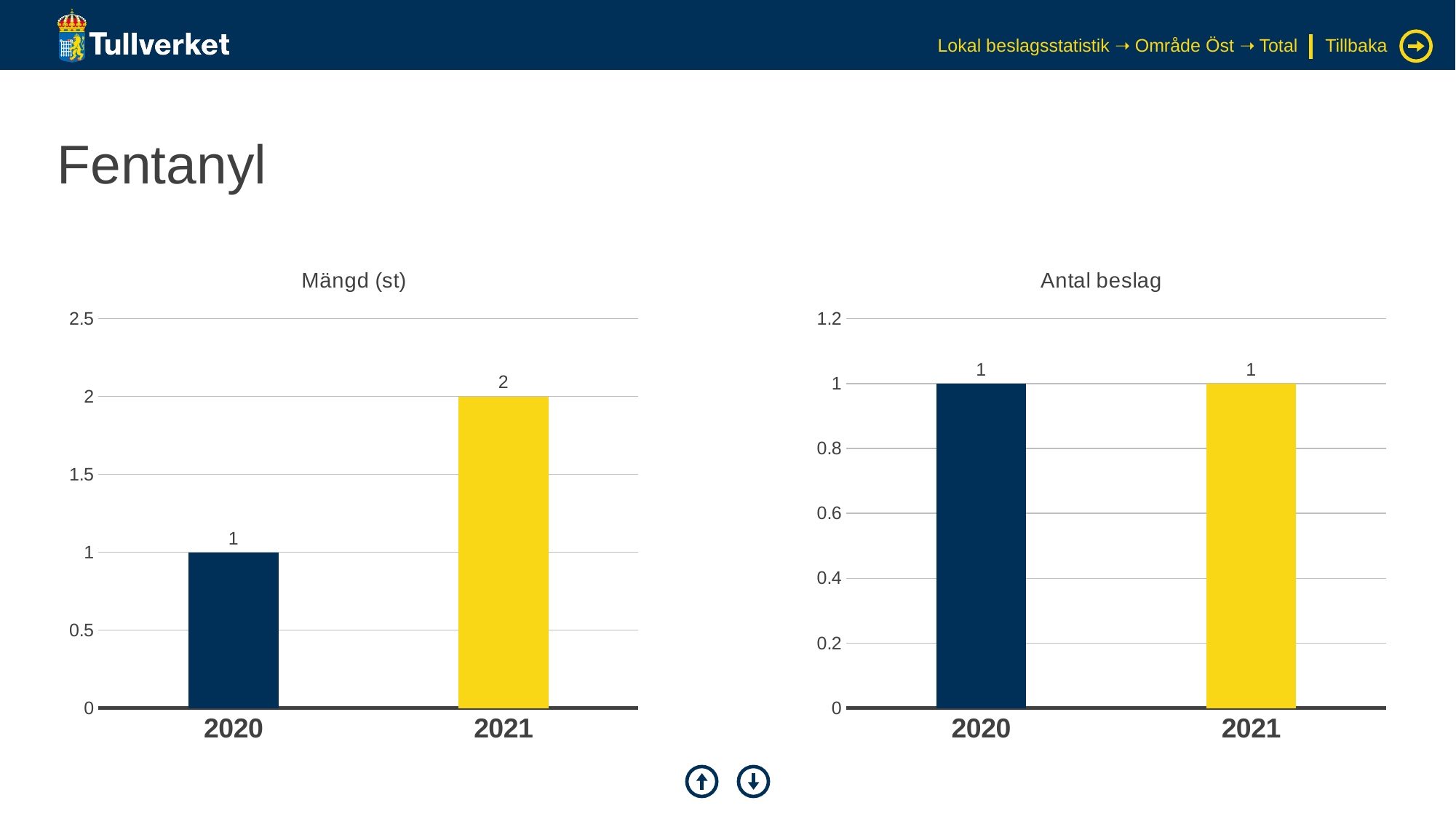
What type of chart is the 'Mängd (st)' chart? bar chart In the 'Antal beslag' chart, what is the value for 2021? 1 In the 'Mängd (st)' chart, which year has the lowest value? 2020 In the 'Mängd (st)' chart, what is the difference between the values for 2021 and 2020? 1 In the 'Mängd (st)' chart, which year has the highest value? 2021 In the 'Mängd (st)' chart, what is the value for 2021? 2 In the 'Mängd (st)' chart, do the values rise or fall from 2020 to 2021? rise In the 'Antal beslag' chart, is the value for 2021 greater or less than 0.8? greater How many years are shown in the 'Antal beslag' chart? 2 What is the title of the chart on the right side of the slide? Antal beslag In the 'Antal beslag' chart, what is the value for 2020? 1 In the 'Mängd (st)' chart, what is the value for 2020? 1